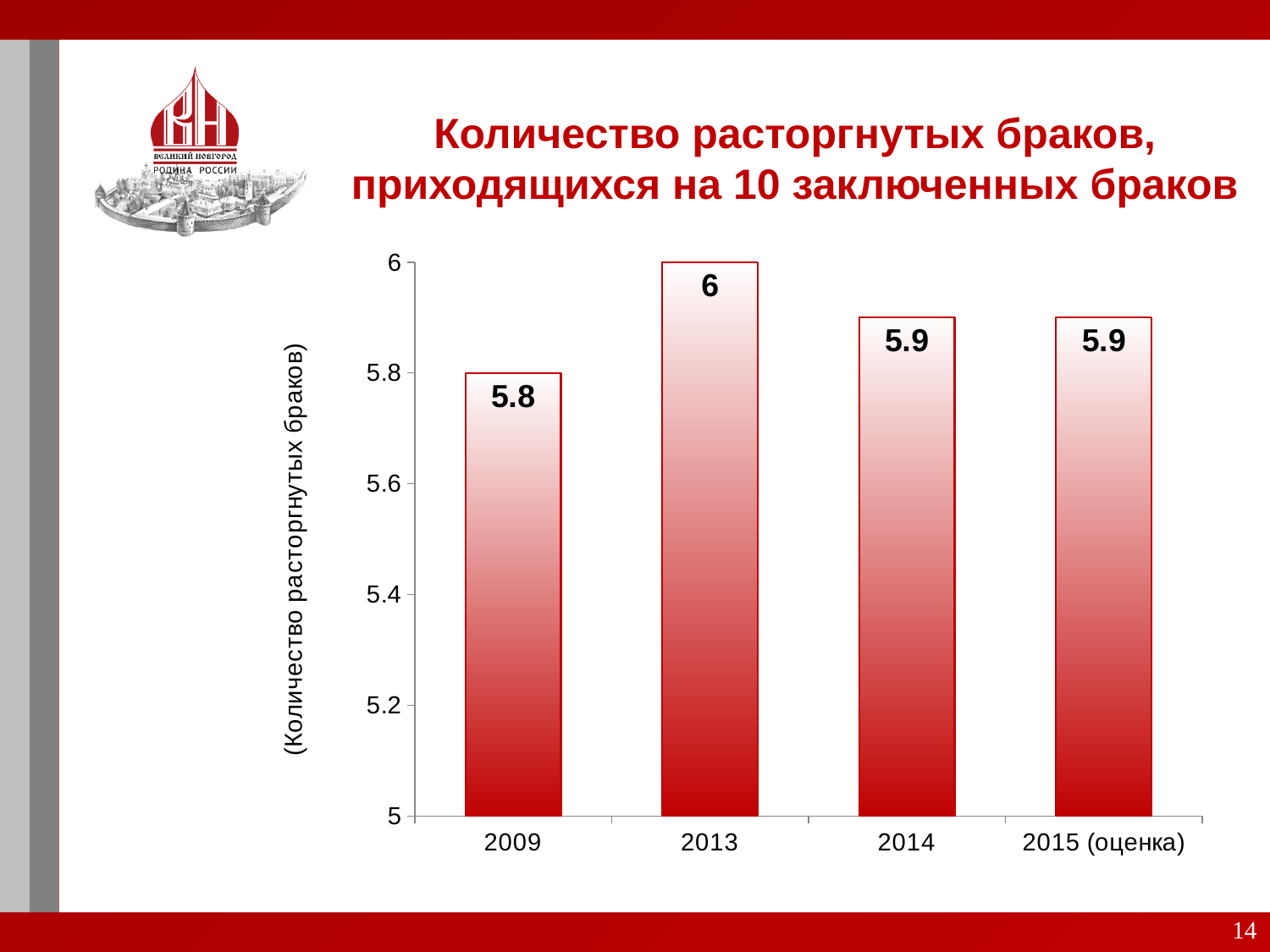
What is the value for 2009? 5.8 What kind of chart is shown on the slide? bar chart Which year has the highest value? 2013 What is the title of the chart? Количество расторгнутых браков, приходящихся на 10 заключенных браков Which year has the lowest value? 2009 What is the difference between the values for 2013 and 2009? 0.2 How many categories are shown on the x axis? 4 Is the value for 2009 greater or less than 5.6? greater What is the value for 2015 (оценка)? 5.9 What is the value for 2013? 6 What is the value for 2014? 5.9 Which is larger, the value for 2013 or the value for 2014? 2013